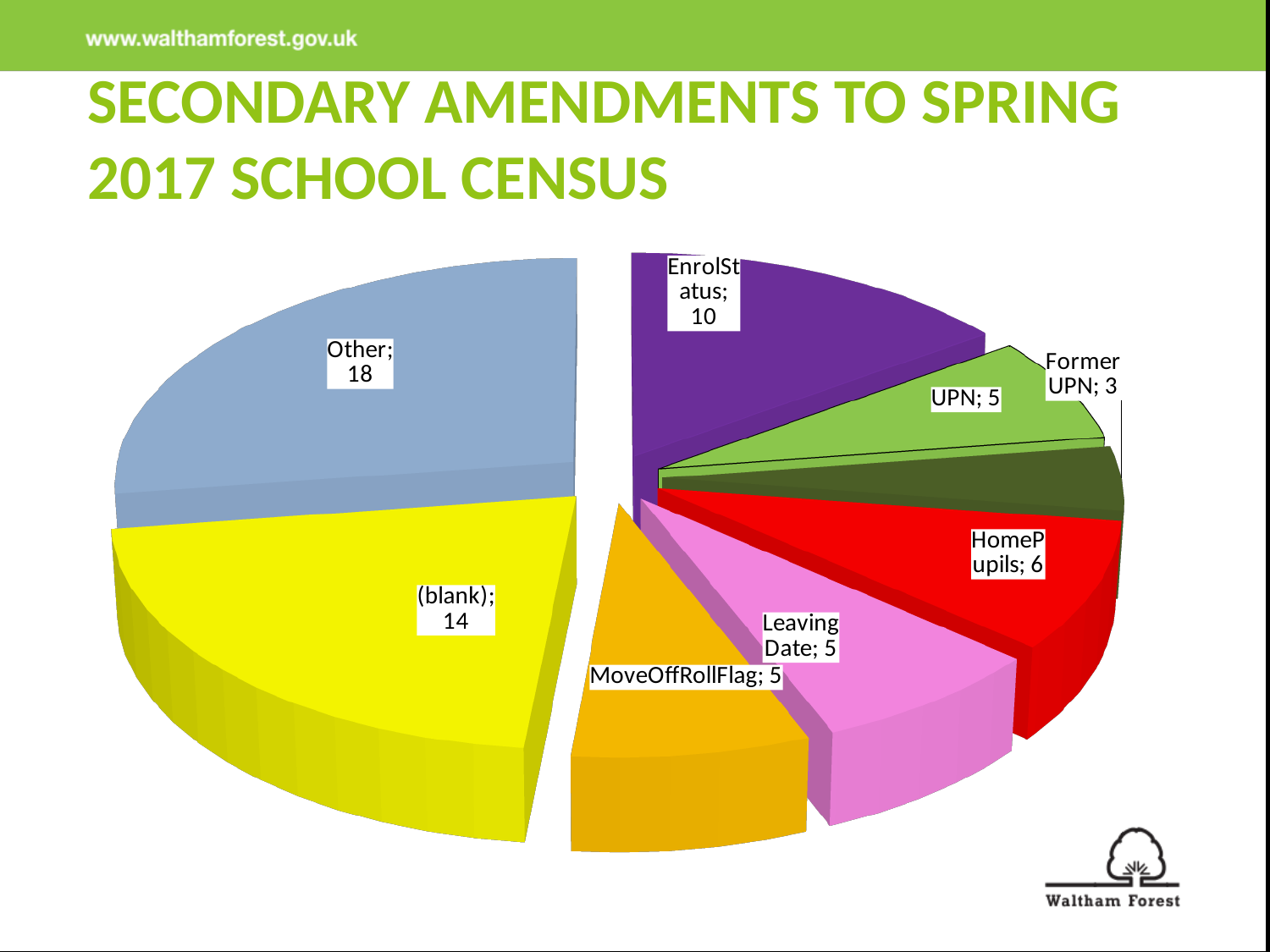
What kind of chart is shown on the slide? Pie chart What is the title of the slide containing the chart? SECONDARY AMENDMENTS TO SPRING 2017 SCHOOL CENSUS What is the value for the (blank) slice? 14 What is the difference between the Other value and the (blank) value? 4 Which category has the largest slice of the pie? Other Which category has the smallest slice of the pie? Former UPN How many slices does the pie chart have? 8 What is the value for the Other slice? 18 What is the value for EnrolStatus? 10 What is the value for Former UPN? 3 Which is larger, the value for HomePupils or the value for UPN? HomePupils What is the value for HomePupils? 6